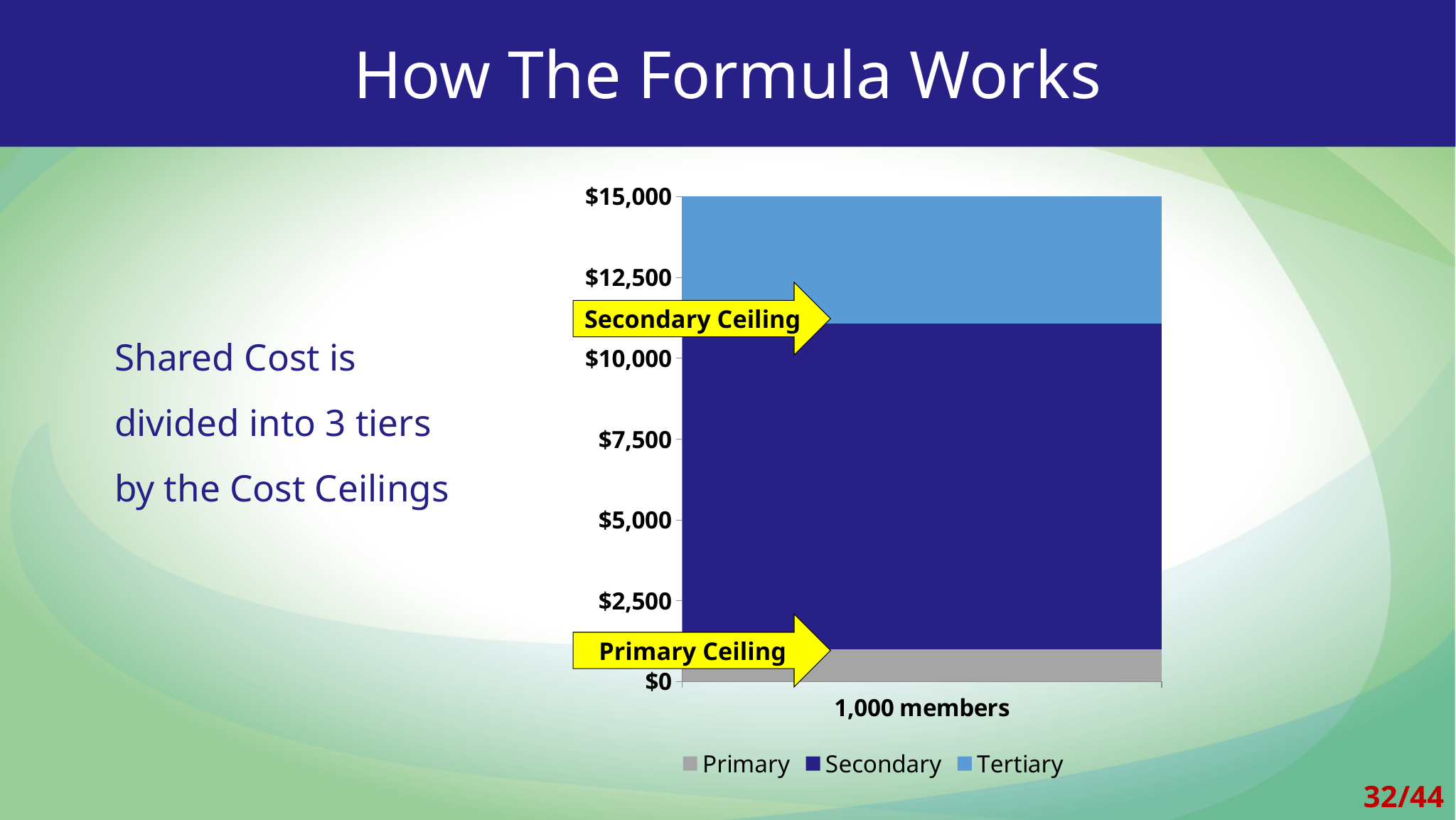
What is the total height of the stacked bar for 1,000 members? $15,000 Which segment is larger, Secondary or Tertiary? Secondary Is the top of the Secondary segment (the Secondary Ceiling) greater or less than $12,500? less Which series forms the largest segment of the stacked bar? Secondary How many categories are plotted on the x axis of the chart? 1 Is the value of the Primary segment greater or less than $2,500? less What is the label of the single category on the x axis? 1,000 members Is the top of the Secondary segment (the Secondary Ceiling) greater or less than $10,000? greater What are the two ceilings labelled by the yellow arrows on the chart? Primary Ceiling and Secondary Ceiling How many series does the chart legend list? 3 Which series forms the smallest segment of the stacked bar? Primary What kind of chart is shown on the slide? Stacked bar chart